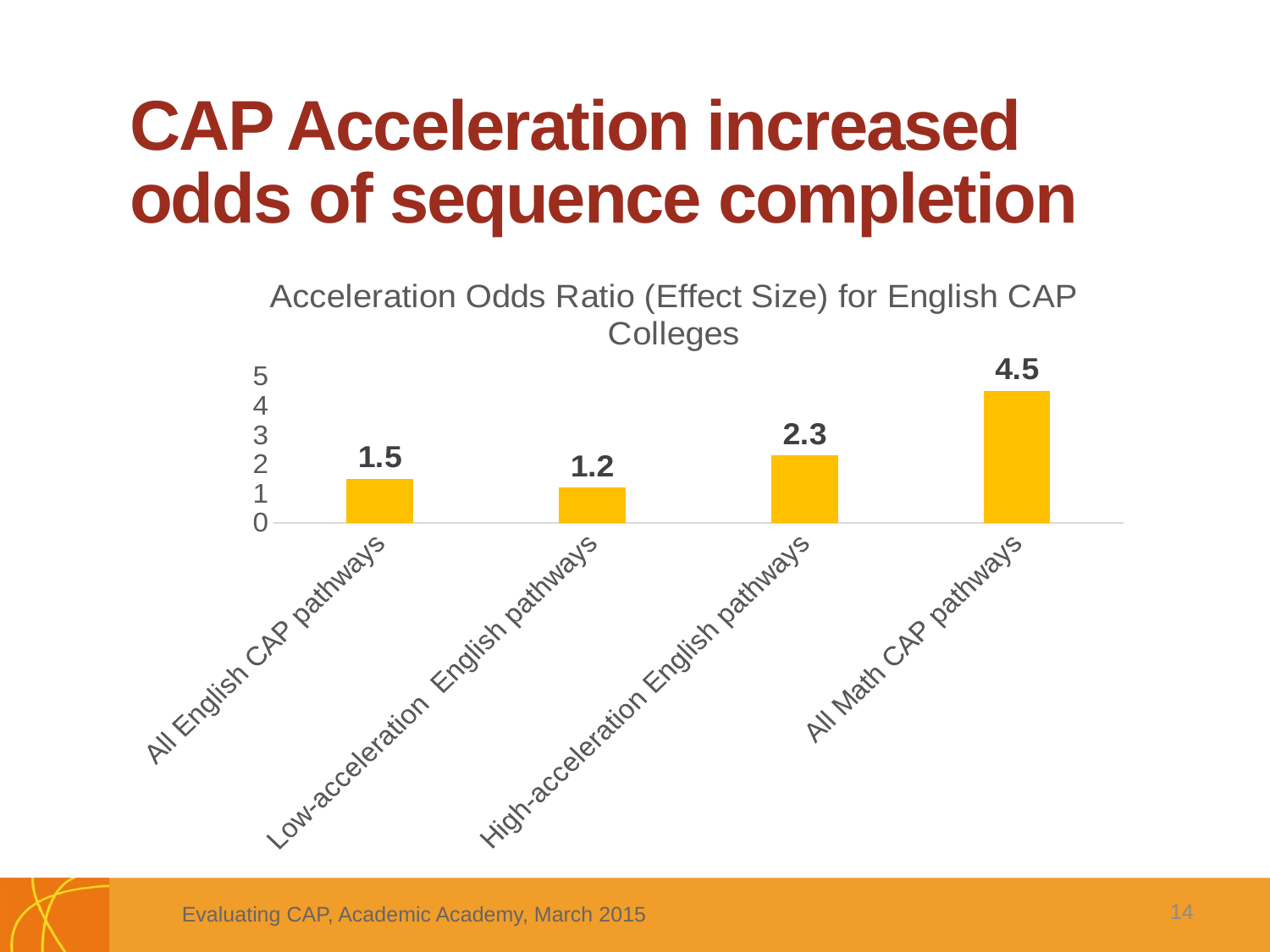
What is the acceleration odds ratio for All English CAP pathways? 1.5 What is the difference between the odds ratio for High-acceleration English pathways and Low-acceleration English pathways? 1.1 What is the acceleration odds ratio for High-acceleration English pathways? 2.3 What is the acceleration odds ratio for Low-acceleration English pathways? 1.2 How many categories are shown in the chart? 4 What kind of chart is shown on the slide? Bar chart What is the title of the chart? Acceleration Odds Ratio (Effect Size) for English CAP Colleges Which is larger, the odds ratio for High-acceleration English pathways or for All English CAP pathways? High-acceleration English pathways What is the difference between the odds ratio for All Math CAP pathways and All English CAP pathways? 3.0 Which category has the lowest acceleration odds ratio? Low-acceleration English pathways What is the acceleration odds ratio for All Math CAP pathways? 4.5 Which category has the highest acceleration odds ratio? All Math CAP pathways